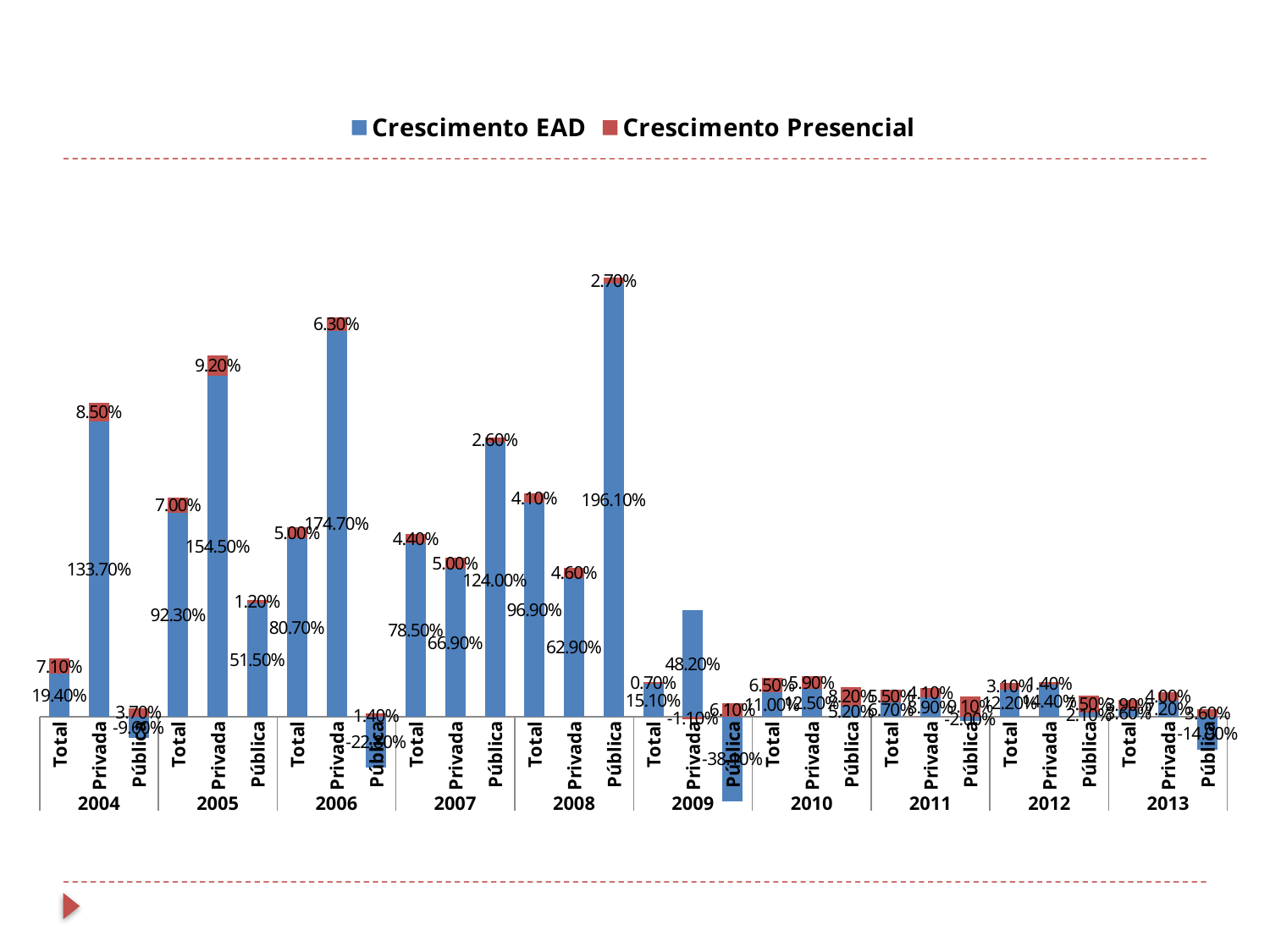
What is the Crescimento EAD value for Total in 2005? 92.30% Which is larger: the Crescimento EAD value for Privada in 2006 or for Pública in 2007? Privada in 2006 What is the Crescimento EAD value for Pública in 2008? 196.10% What is the combined total of the stacked bar for Privada in 2004 (Crescimento EAD plus Crescimento Presencial)? 142.20% How many series does the legend list? 2 What is the Crescimento Presencial value for Privada in 2005? 9.20% What kind of chart is shown on the slide? Stacked bar chart What is the difference between the Crescimento EAD values for Privada in 2005 and Privada in 2004? 20.80% How many years are shown along the x axis? 10 What are the two series named in the legend? Crescimento EAD and Crescimento Presencial What is the Crescimento EAD value for Privada in 2004? 133.70% Which category and year has the highest Crescimento EAD value? Pública 2008